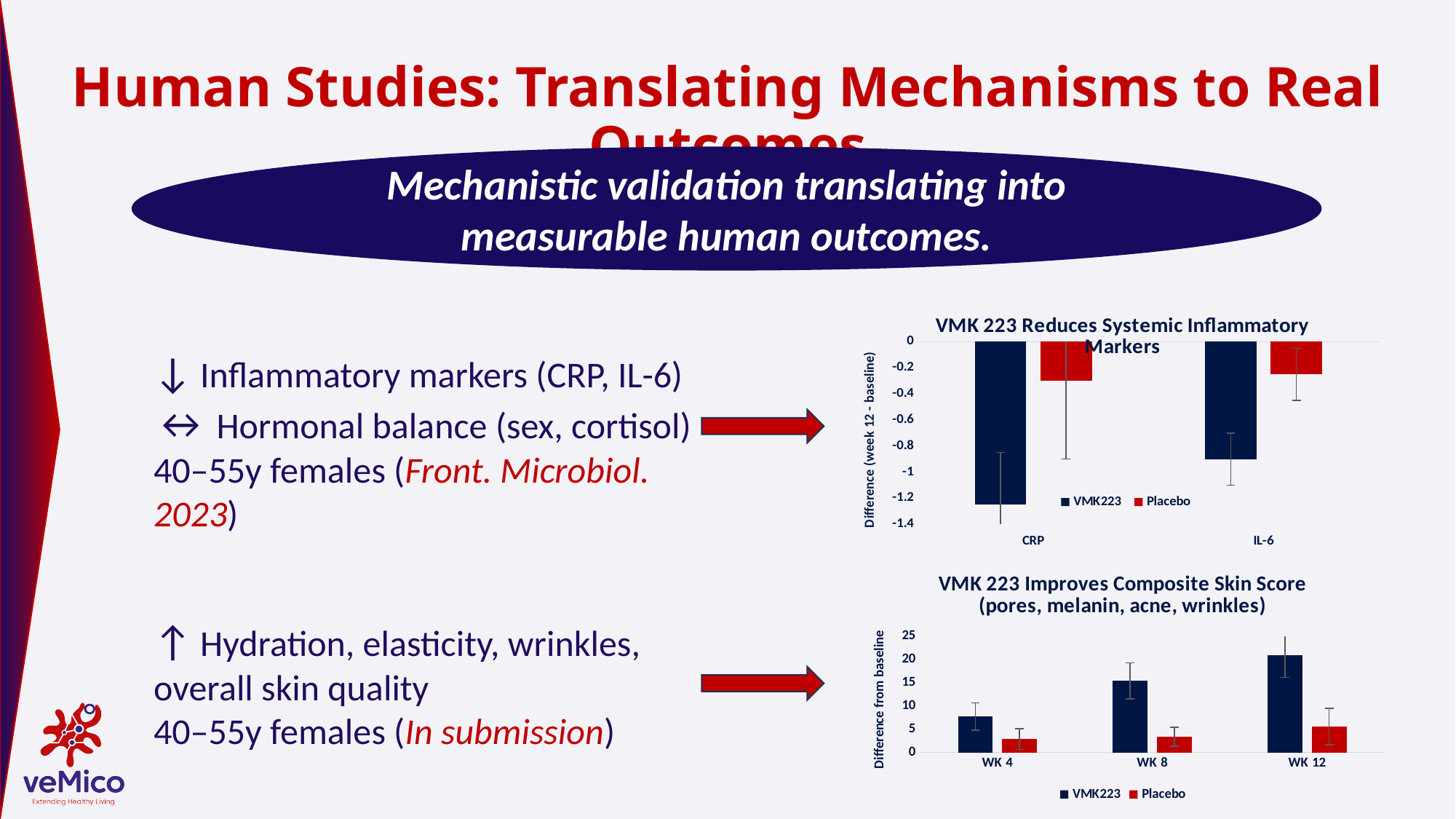
In the chart titled "VMK 223 Reduces Systemic Inflammatory Markers", which series shows the larger decrease for IL-6, VMK223 or Placebo? VMK223 In the chart titled "VMK 223 Reduces Systemic Inflammatory Markers", what kind of chart is shown? bar chart In the chart titled "VMK 223 Improves Composite Skin Score", is the VMK223 value at WK 12 greater or less than 15? greater In the chart titled "VMK 223 Reduces Systemic Inflammatory Markers", what is the y-axis label? Difference (week 12 - baseline) In the chart titled "VMK 223 Improves Composite Skin Score", at which time point is the VMK223 value lowest? WK 4 In the chart titled "VMK 223 Reduces Systemic Inflammatory Markers", how many categories are shown on the x axis? 2 In the chart titled "VMK 223 Improves Composite Skin Score", how many time points are shown on the x axis? 3 In the chart titled "VMK 223 Improves Composite Skin Score", what kind of chart is shown? bar chart In the chart titled "VMK 223 Reduces Systemic Inflammatory Markers", is the VMK223 value for CRP greater or less than -1? less In the chart titled "VMK 223 Improves Composite Skin Score", at which time point is the VMK223 value highest? WK 12 In the chart titled "VMK 223 Reduces Systemic Inflammatory Markers", how many series does the legend list? 2 In the chart titled "VMK 223 Improves Composite Skin Score", do the VMK223 values rise or fall from WK 4 to WK 12? rise